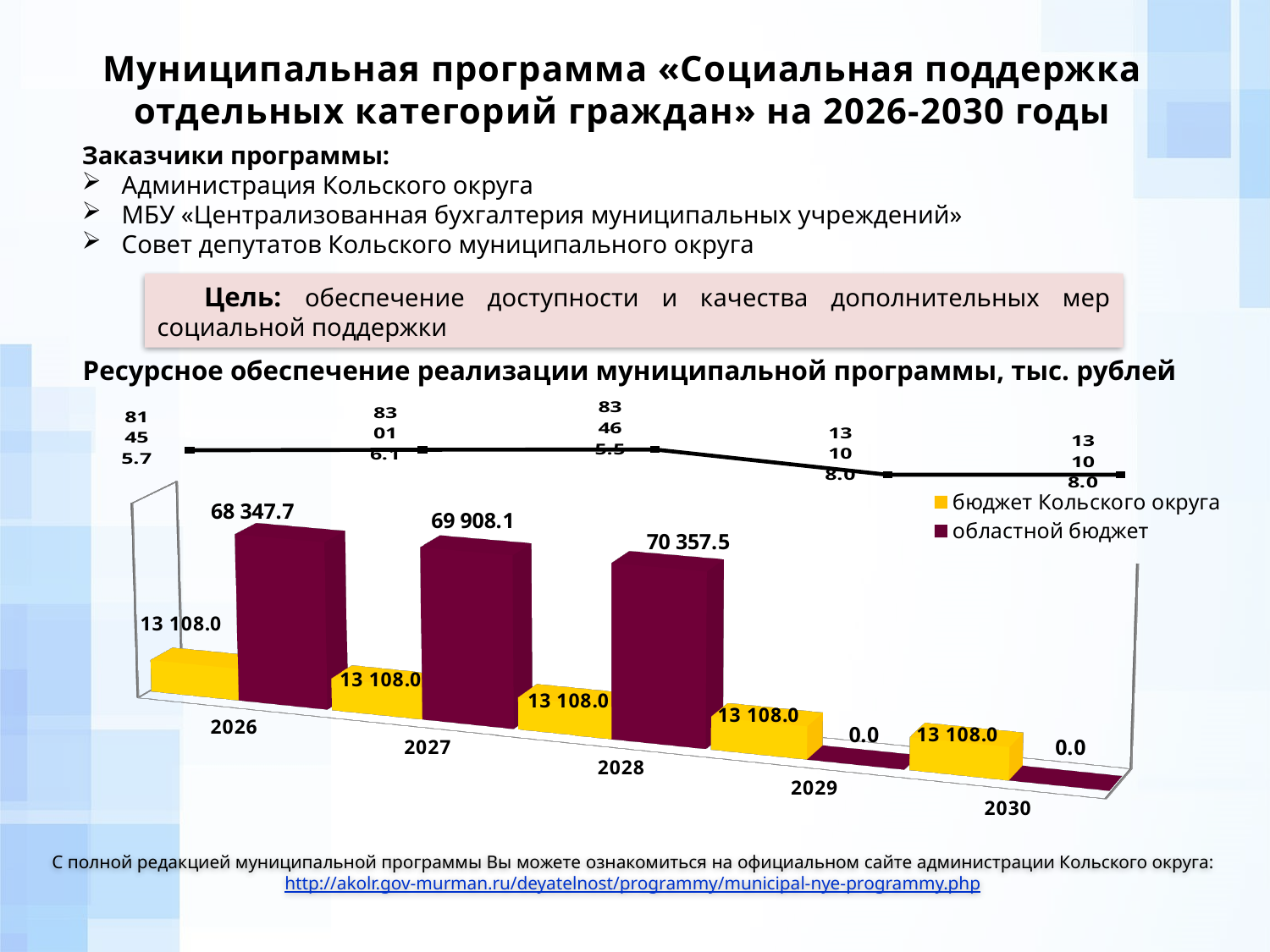
How many years are shown on the x axis of the chart? 5 What kind of chart is used to show the resource provision data? bar chart What is the difference between the областной бюджет and бюджет Кольского округа values in 2026? 55 239.7 What is the value for областной бюджет in 2028? 70 357.5 What is the value for областной бюджет in 2026? 68 347.7 Which colour represents бюджет Кольского округа in the chart? yellow What is the value for областной бюджет in 2030? 0.0 In which year is the областной бюджет value highest? 2028 Which is larger in 2027: областной бюджет or бюджет Кольского округа? областной бюджет How many series does the chart legend list? 2 What is the value for бюджет Кольского округа in 2027? 13 108.0 What is the difference between the областной бюджет values for 2028 and 2027? 449.4